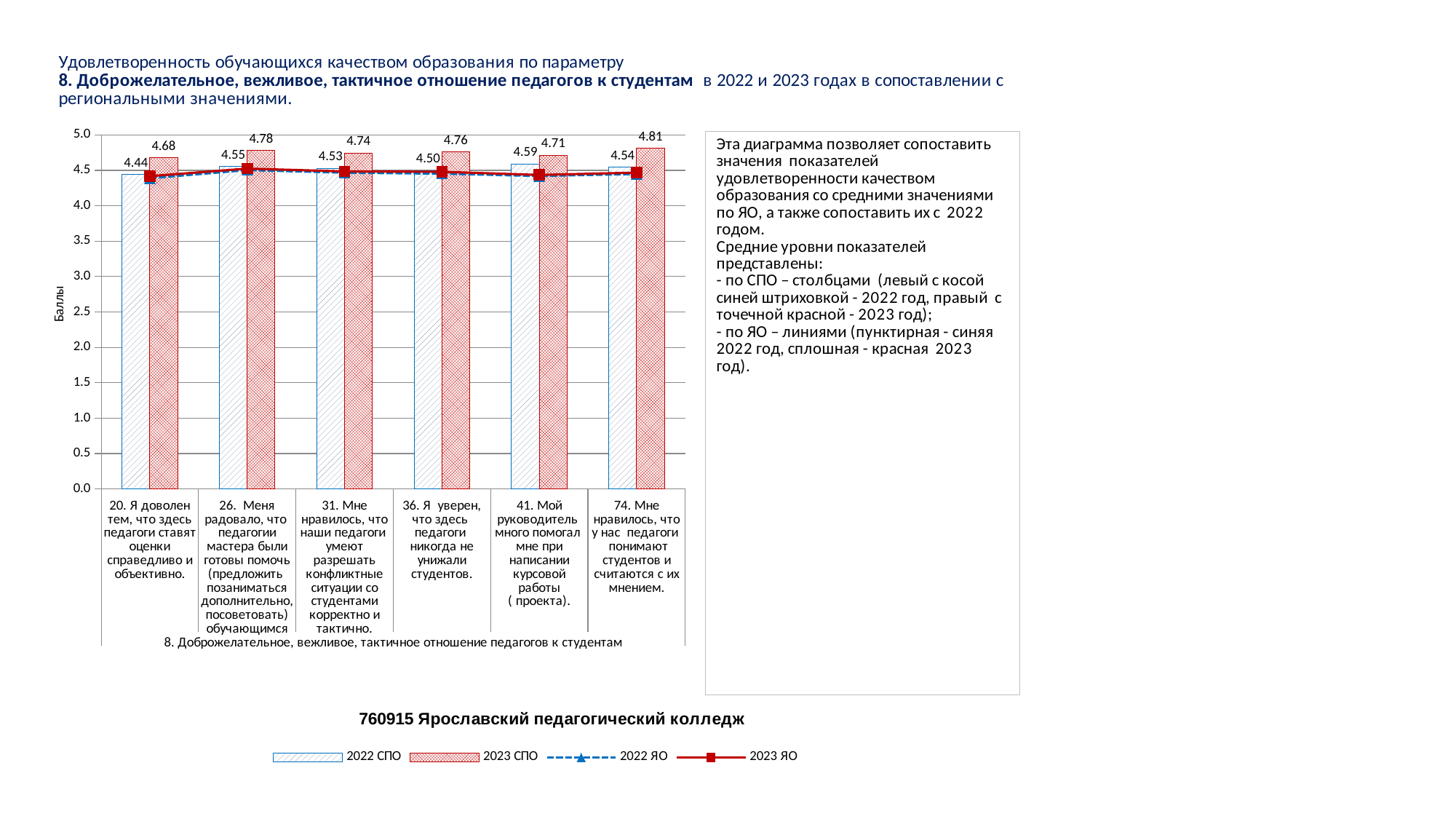
Which item has the highest 2023 СПО value? 74. Мне нравилось, что у нас педагоги понимают студентов и считаются с их мнением. Which item has the highest 2022 СПО value? 41. Мой руководитель много помогал мне при написании курсовой работы (проекта). How many items (categories) are shown on the x axis of the chart? 6 What type of chart is shown on the slide? Combined bar and line chart What is the difference between the 2023 СПО and 2022 СПО values for item 74? 0.27 How many series does the chart legend list? 4 Is the 2023 СПО value for item 41 greater or less than 4.5? greater What is the 2023 СПО value for item 74 (Мне нравилось, что у нас педагоги понимают студентов и считаются с их мнением)? 4.81 Which item has the lowest 2022 СПО value? 20. Я доволен тем, что здесь педагоги ставят оценки справедливо и объективно. What is the 2022 СПО value for item 20 (Я доволен тем, что здесь педагоги ставят оценки справедливо и объективно)? 4.44 What is the 2023 СПО value for item 36 (Я уверен, что здесь педагоги никогда не унижали студентов)? 4.76 Which is larger for item 26: the 2022 СПО value or the 2023 СПО value? 2023 СПО